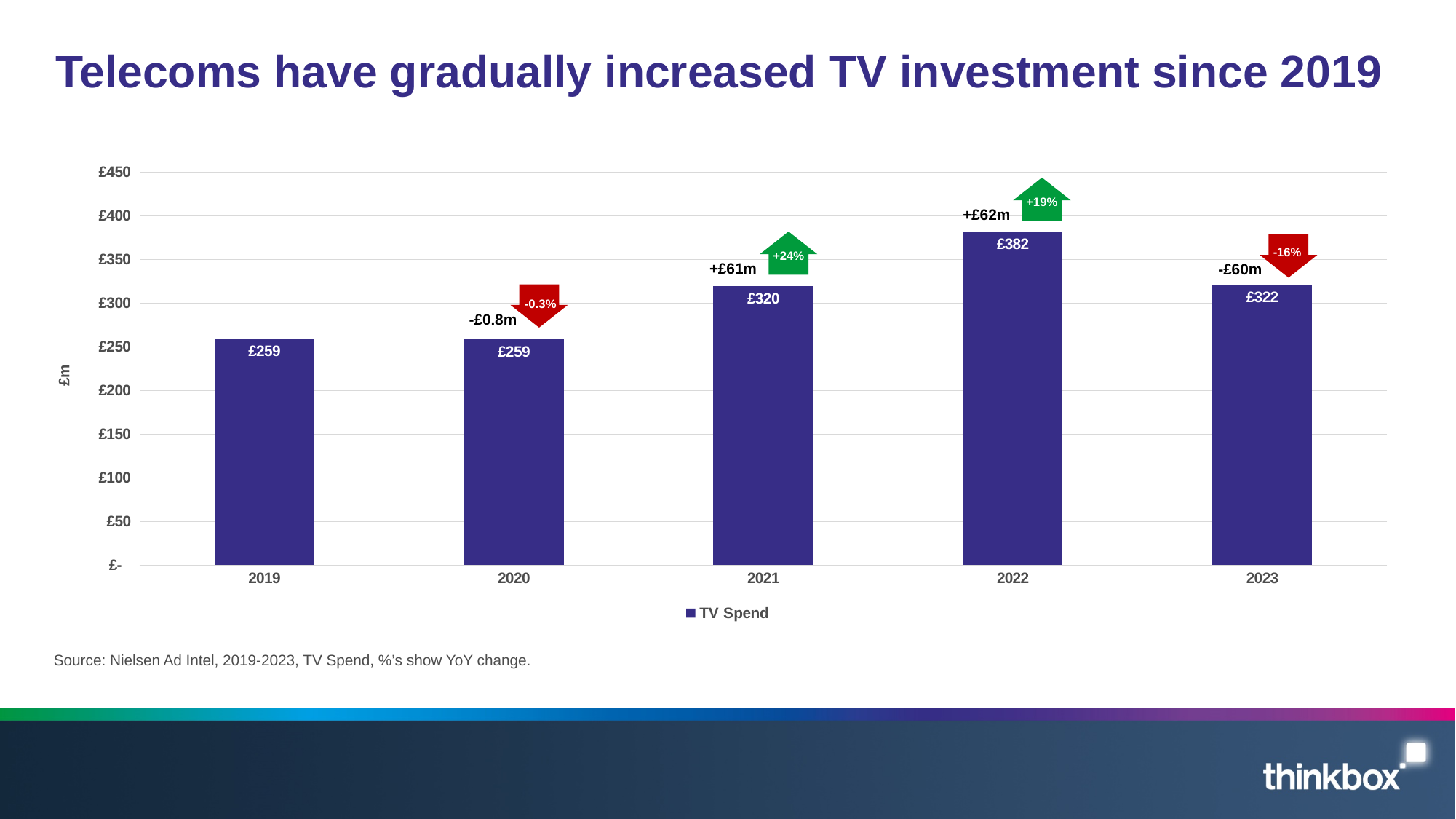
What is the difference in TV Spend between 2022 and 2021? £62 What kind of chart is shown on the slide? bar chart Is the TV Spend value for 2022 greater or less than £350? greater How many series does the legend list? 1 Which is larger, the TV Spend for 2023 or for 2021? 2023 What is the TV Spend value for 2021? £320 What is the title of the chart? Telecoms have gradually increased TV investment since 2019 What is the year-on-year change in £m shown for 2023? -£60m How many years are shown on the x axis? 5 What is the TV Spend value for 2023? £322 What is the year-on-year percentage change shown for 2022? +19% Which year has the highest TV Spend? 2022